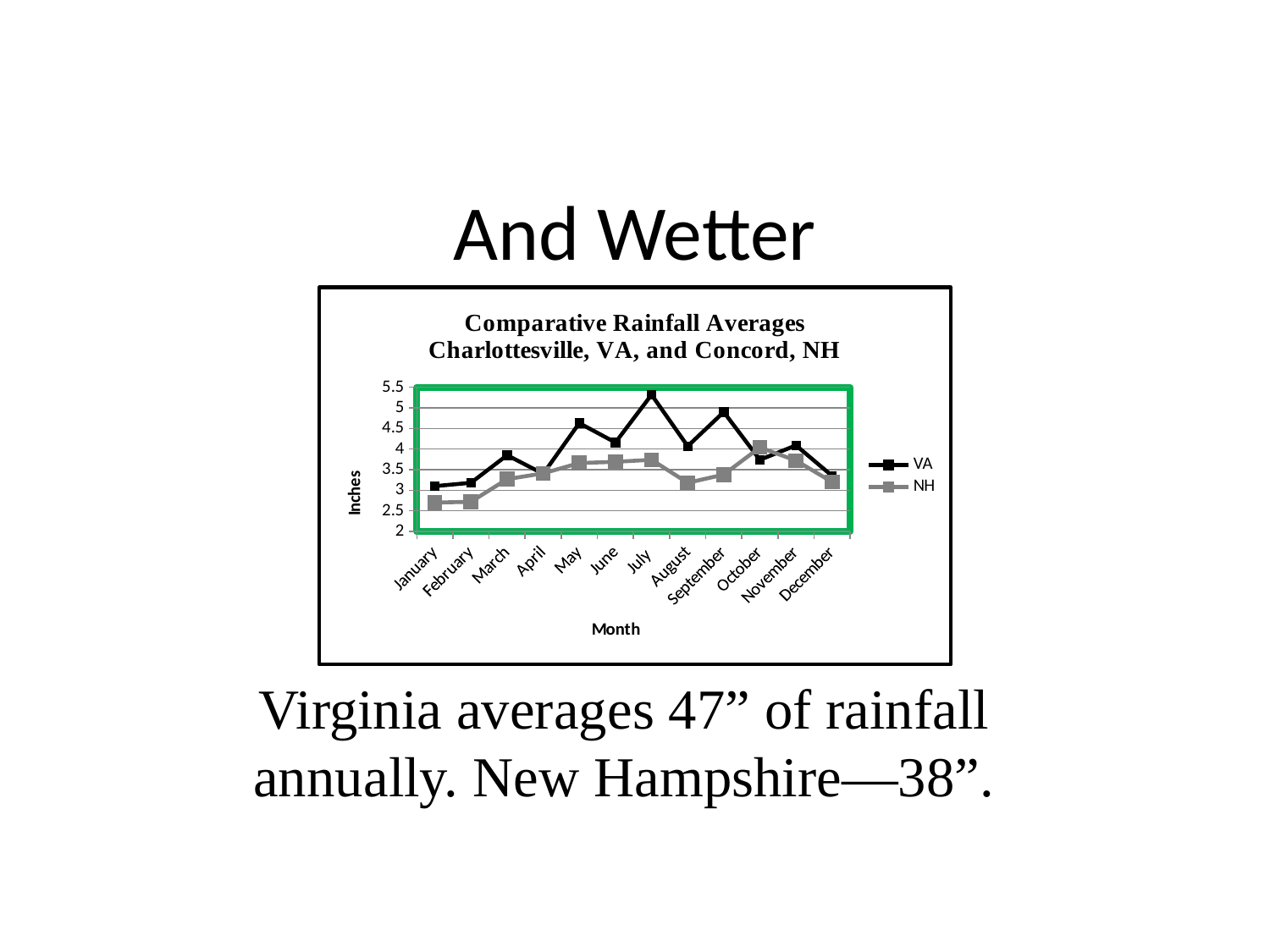
In which month does the NH series reach its highest value? October Which series has the larger value in May, VA or NH? VA In which month does the VA series reach its highest value? July Is the value for VA in September greater or less than 4.5? greater Which series has the larger value in July, VA or NH? VA How many series does the legend list? 2 How many months are plotted along the x axis? 12 Is the value for NH in January greater or less than 3? less What is the label on the vertical axis? Inches What is the title of the chart? Comparative Rainfall Averages Charlottesville, VA, and Concord, NH What kind of chart is shown on the slide? line chart Is the value for VA in July greater or less than 5? greater